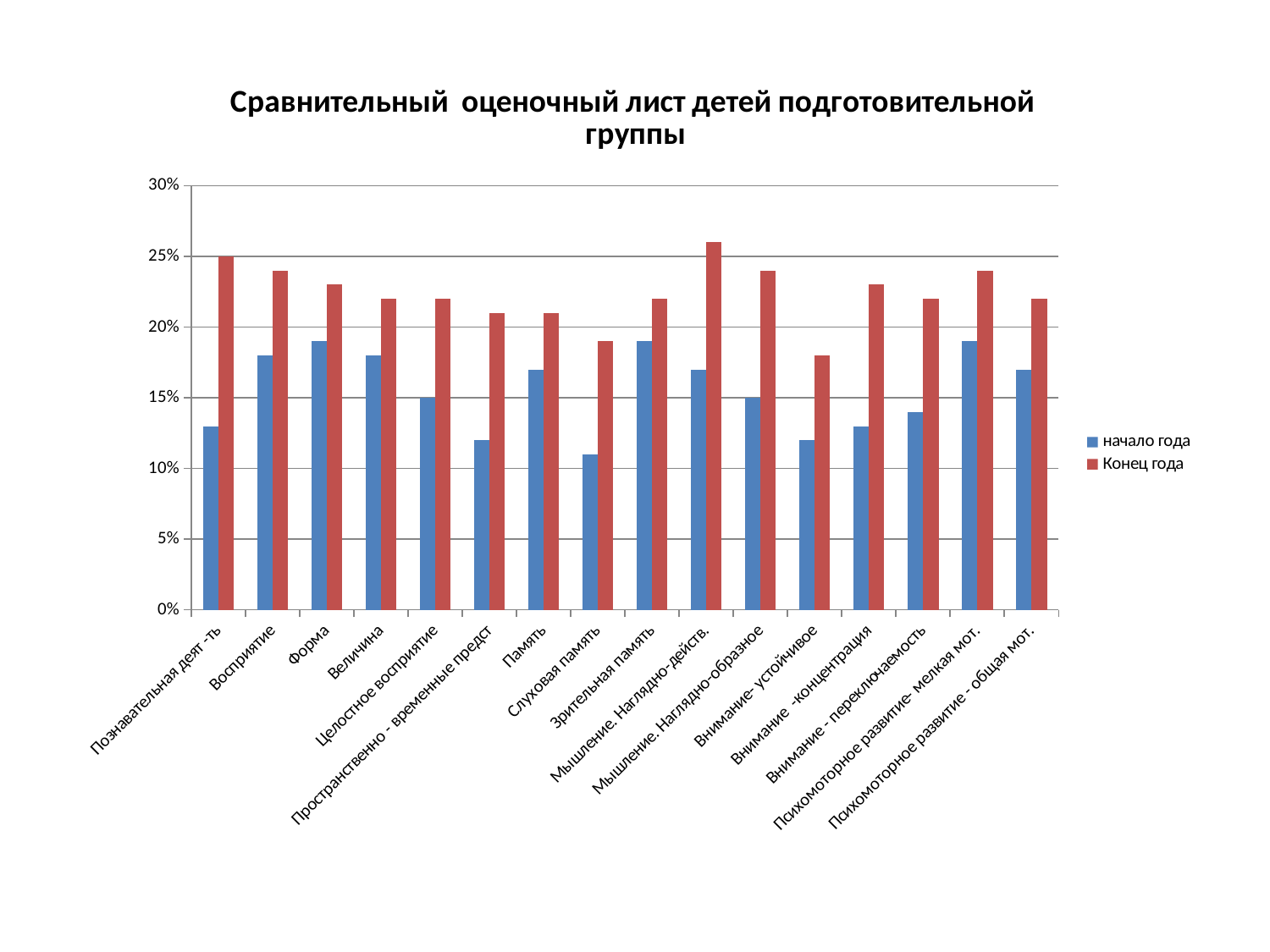
Is the Конец года value for Внимание- устойчивое greater or less than 20%? less How many series does the legend list? 2 Which category has the highest value for Конец года? Мышление. Наглядно-действ. Which category has the lowest value for начало года? Слуховая память Is the начало года value for Форма greater or less than 15%? greater What are the two series named in the legend? начало года, Конец года Is the Конец года value for Мышление. Наглядно-действ. greater or less than 25%? greater What is the title of the chart? Сравнительный оценочный лист детей подготовительной группы How many categories are shown along the x axis? 16 For Восприятие, which is larger: the начало года value or the Конец года value? Конец года What kind of chart is shown on the slide? bar chart